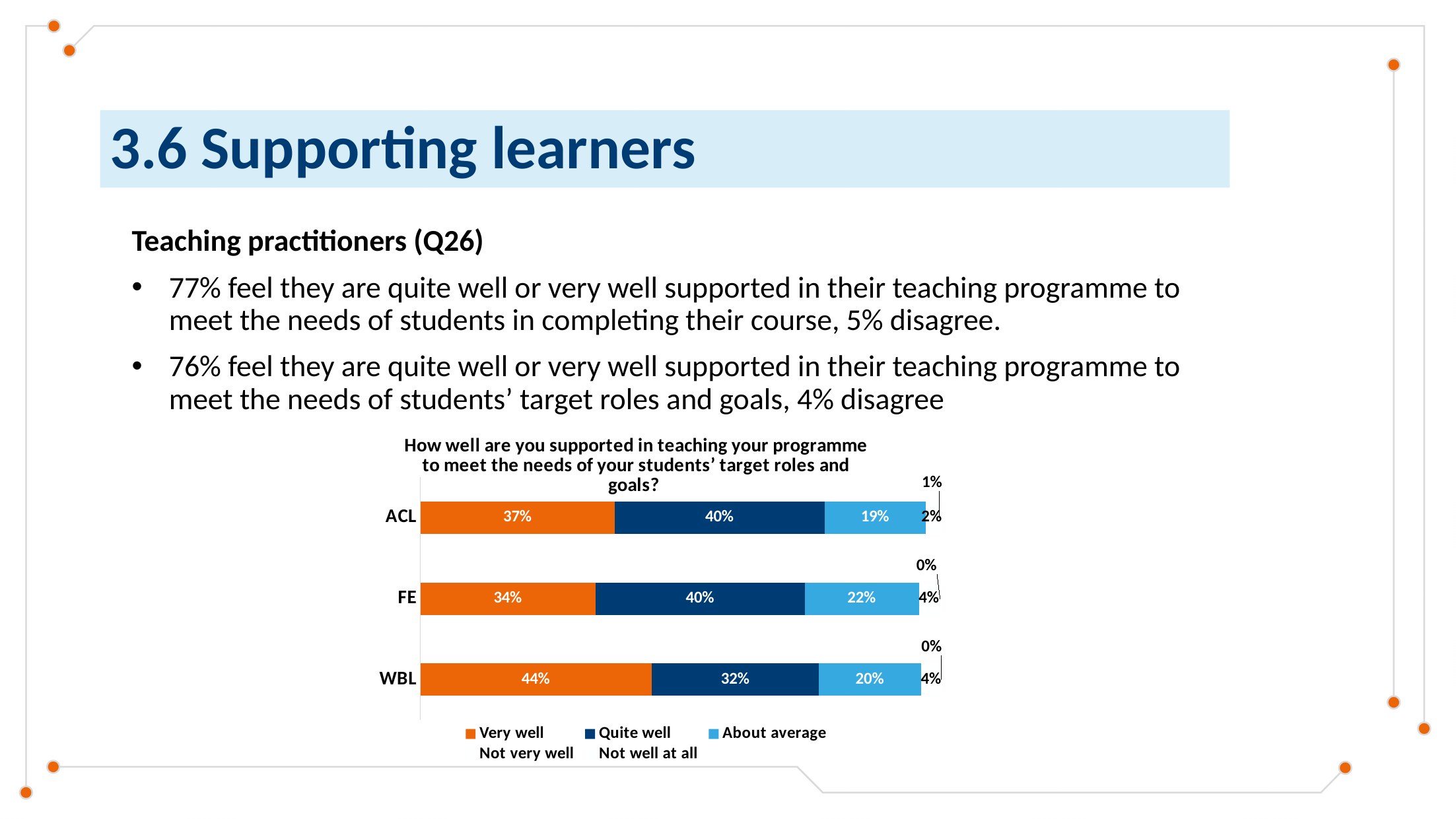
What is the difference between the "Very well" values for WBL and ACL? 7% What is the "About average" value for FE? 22% What is the "Very well" value for FE? 34% How many series does the legend list? 5 How many categories are shown on the chart? 3 What is the "Quite well" value for WBL? 32% What colour represents "Very well" in the chart? Orange Which category has the lowest "Quite well" percentage? WBL What type of chart is shown on the slide? Stacked bar chart What percentage of ACL respondents answered "Very well"? 37% Which is larger: the "About average" value for FE or for ACL? FE Which category has the highest "Very well" percentage? WBL